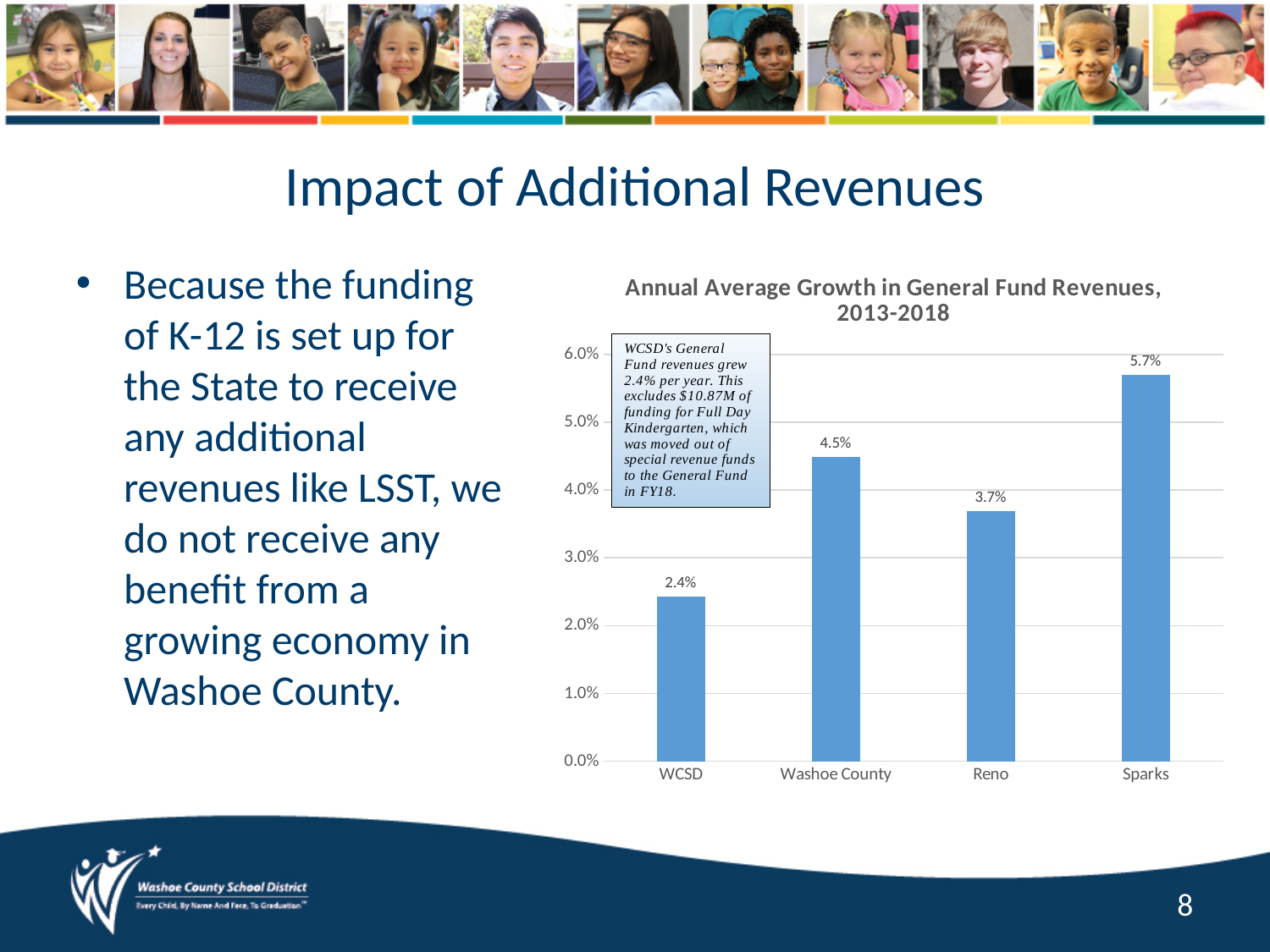
What is the difference between the growth rates for Washoe County and Reno? 0.8% What is the annual average growth in General Fund revenues for Reno? 3.7% What is the annual average growth in General Fund revenues for Sparks? 5.7% How many categories are shown on the chart? 4 What is the annual average growth in General Fund revenues for Washoe County? 4.5% Which has a higher annual average growth in General Fund revenues, Reno or Washoe County? Washoe County Which category has the lowest annual average growth in General Fund revenues? WCSD What kind of chart is shown on the slide? Bar chart What is the annual average growth in General Fund revenues for WCSD? 2.4% What is the difference between the growth rates for Sparks and WCSD? 3.3% Which category has the highest annual average growth in General Fund revenues? Sparks What is the title of the chart? Annual Average Growth in General Fund Revenues, 2013-2018